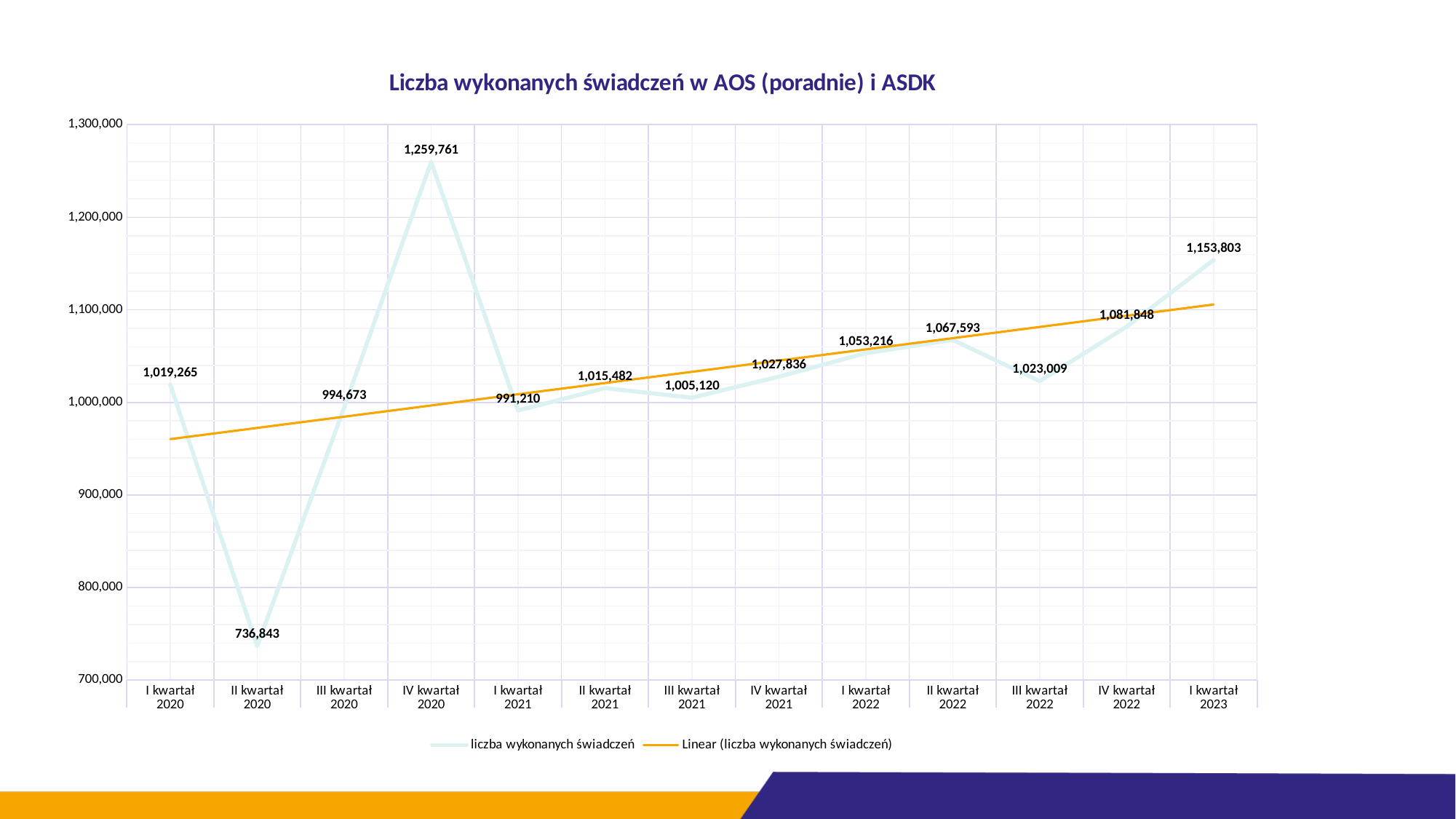
Which quarter has the highest value? IV kwartał 2020 What is the value for I kwartał 2023? 1,153,803 What is the difference between the values for IV kwartał 2020 and II kwartał 2020? 522,918 How many quarters are plotted on the x axis? 13 What kind of chart is shown on the slide? Line chart What is the value for III kwartał 2022? 1,023,009 What is the value for IV kwartał 2020? 1,259,761 How many entries does the legend list? 2 What is the difference between the values for I kwartał 2023 and IV kwartał 2022? 71,955 Which quarter has the lowest value? II kwartał 2020 What is the value for II kwartał 2020? 736,843 Which is larger, the value for I kwartał 2020 or the value for III kwartał 2020? I kwartał 2020